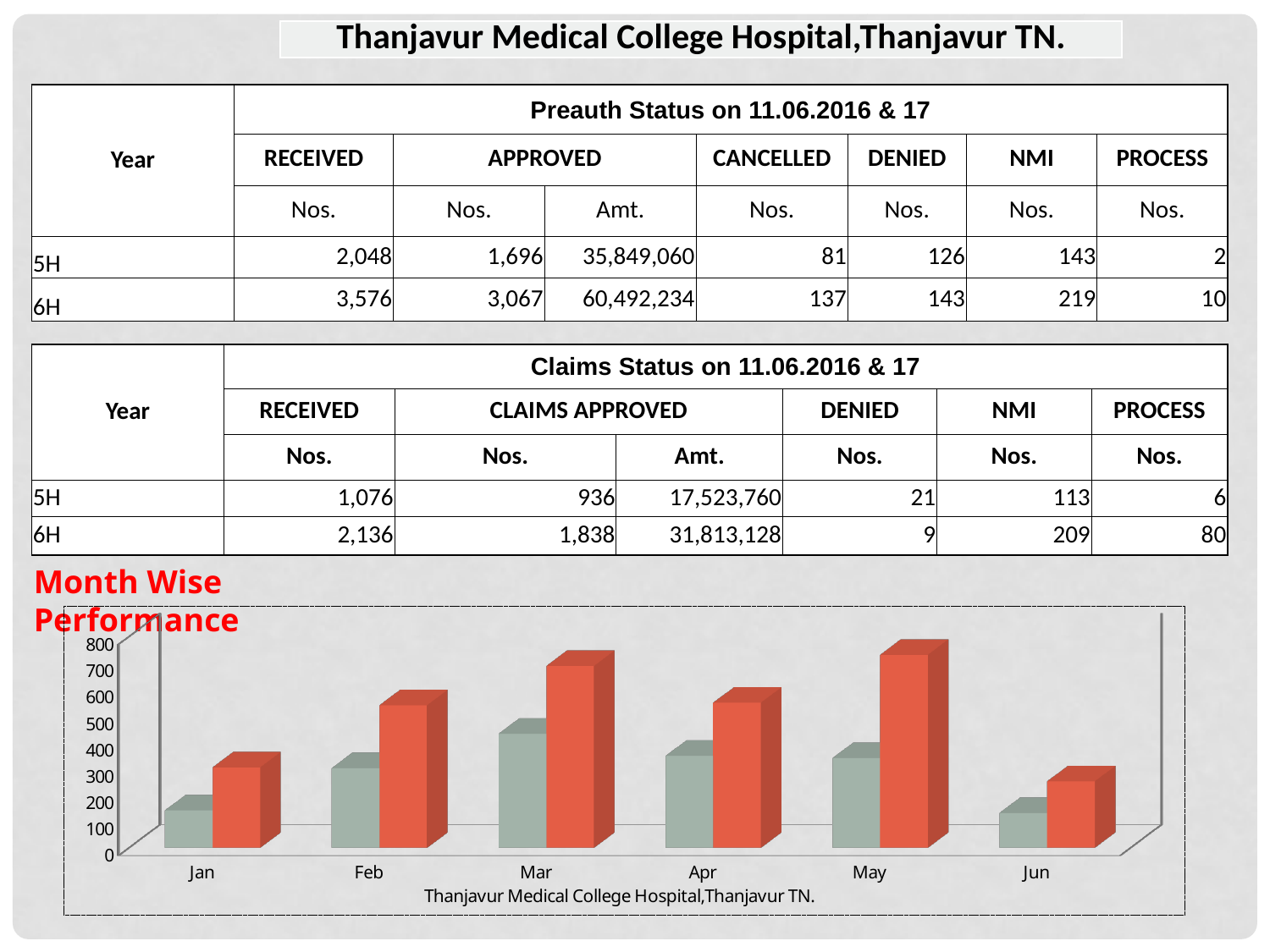
Which is larger in the bar chart: the red bar for Mar or the red bar for Jan? Mar Which month has the shortest red bar in the bar chart? Jun Do the red bars rise or fall from Jan to Mar in the bar chart? rise What kind of chart is shown under the heading 'Month Wise Performance'? bar chart Is the red bar for Feb greater or less than 500? greater Is the grey bar for Apr greater or less than 400? less Is the grey bar for Jun greater or less than 200? less How many months are shown on the x axis of the bar chart? 6 Which month has the tallest grey bar in the bar chart? Mar Which month has the tallest red bar in the bar chart? May What text appears below the x axis of the bar chart? Thanjavur Medical College Hospital,Thanjavur TN.